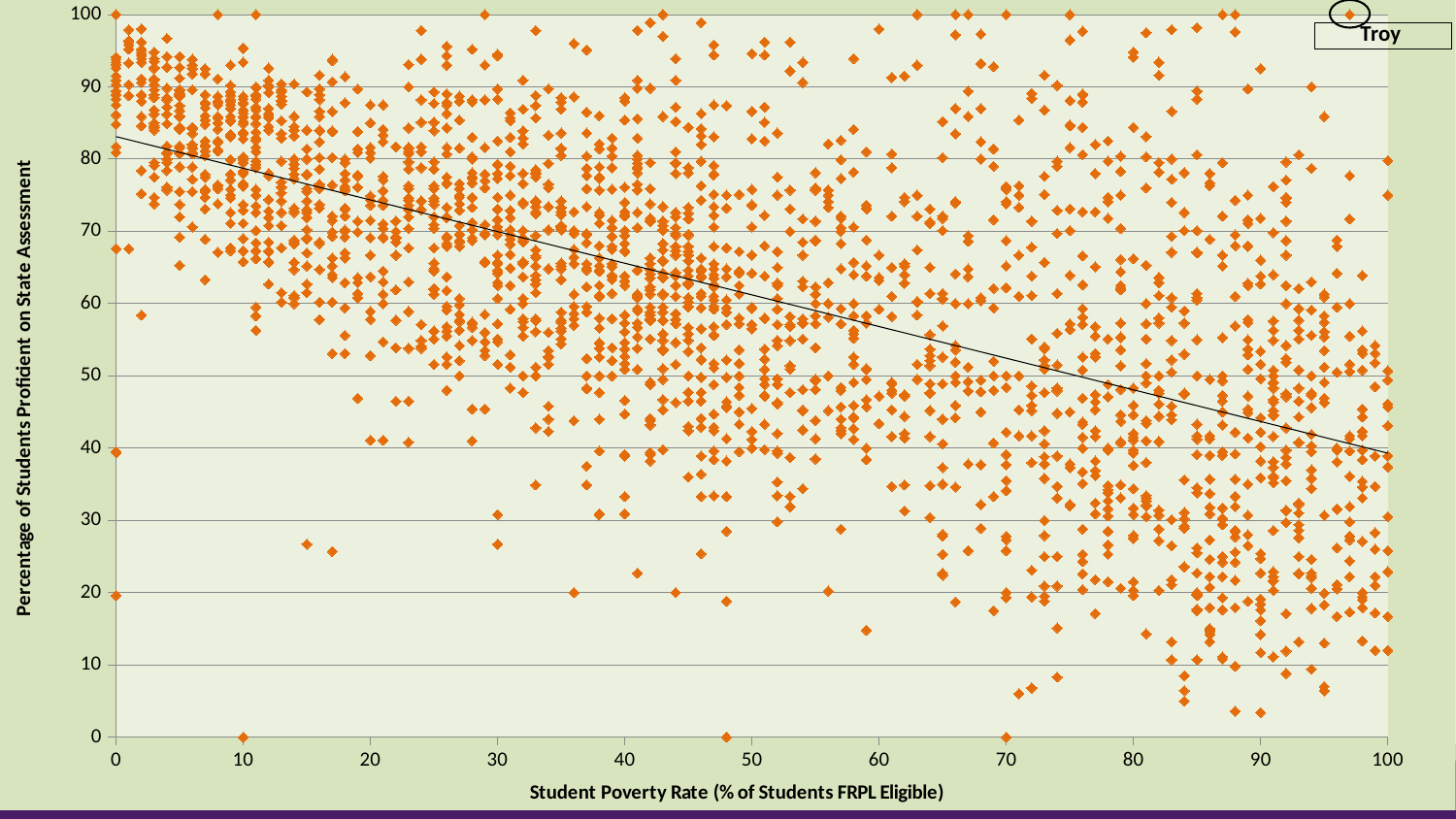
What kind of chart is shown on the slide? scatter plot Is the trend line's value at a student poverty rate of 80 greater or less than 50? less Does the trend line rise or fall as the student poverty rate increases along the x axis? fall How many series does the legend list? 1 What is the label of the y axis? Percentage of Students Proficient on State Assessment What is the label of the x axis? Student Poverty Rate (% of Students FRPL Eligible) What is the maximum value shown on the y axis? 100 Is the trend line's value at a student poverty rate of 100 greater or less than 50? less Is the trend line's value at a student poverty rate of 50 greater or less than 50? greater